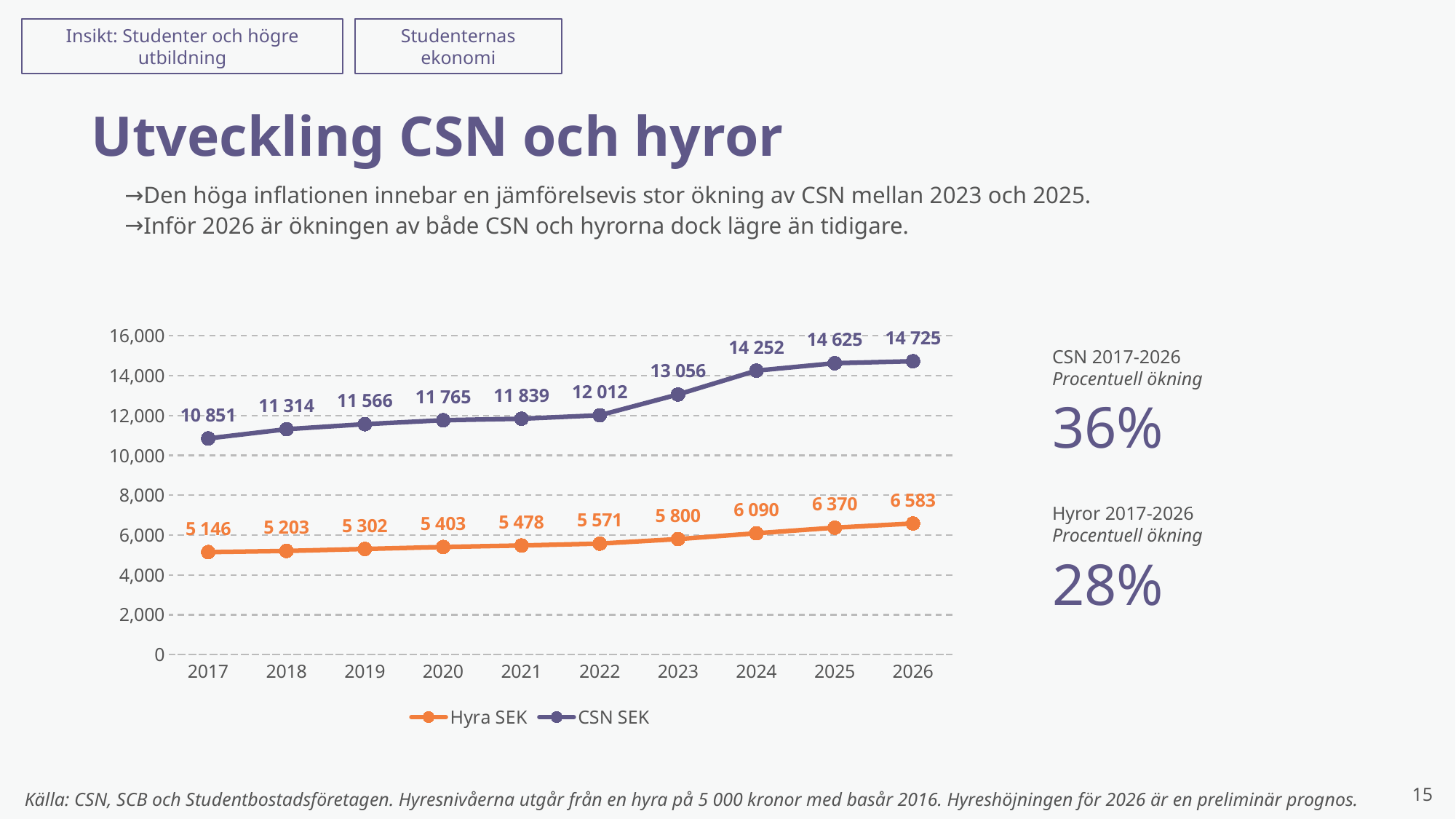
What kind of chart is shown on the slide? line chart How many series does the legend list? 2 Which is larger in 2022: the CSN SEK value or the Hyra SEK value? CSN SEK What is the Hyra SEK value for 2020? 5 403 Does the Hyra SEK series rise or fall from 2017 to 2026? rise In which year is the CSN SEK series lowest? 2017 How many years are shown on the x axis? 10 What is the difference between the CSN SEK values for 2024 and 2023? 1 196 Is the CSN SEK value for 2025 greater or less than 14,000? greater In which year is the Hyra SEK series highest? 2026 What is the CSN SEK value for 2023? 13 056 What is the CSN SEK value for 2017? 10 851